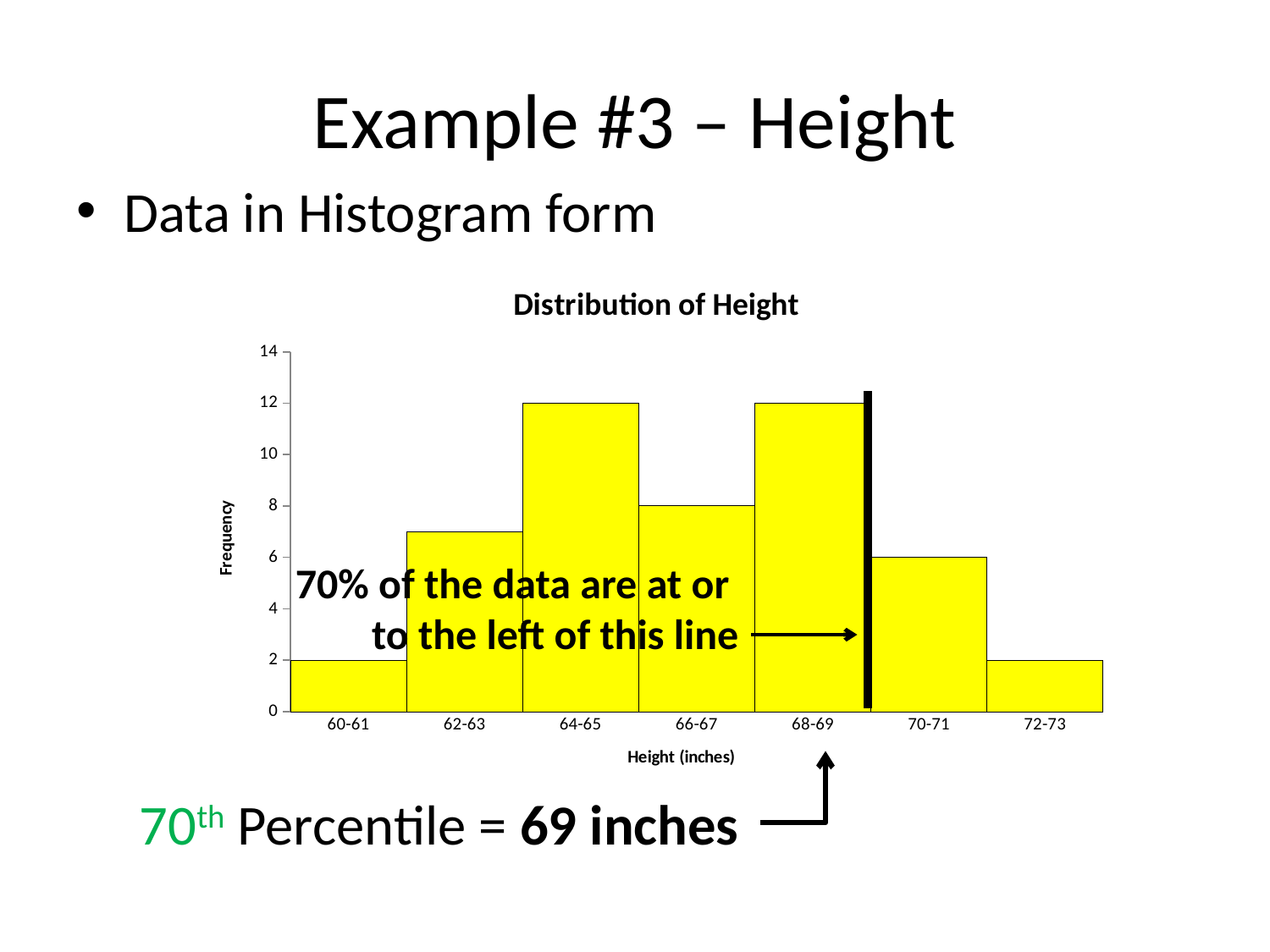
How many height bins are shown on the x axis? 7 Is the frequency for the 68-69 height bin greater or less than 10? greater What is the title of the chart? Distribution of Height What is the frequency for the 66-67 height bin? 8 What is the frequency for the 60-61 height bin? 2 What is the frequency for the 72-73 height bin? 2 What is the frequency for the 70-71 height bin? 6 What kind of chart is shown on the slide? Bar chart (histogram) Which has a higher frequency, the 66-67 bin or the 70-71 bin? 66-67 Is the frequency for the 62-63 height bin greater or less than 6? greater What is the difference in frequency between the 68-69 bin and the 70-71 bin? 6 What is the frequency for the 64-65 height bin? 12